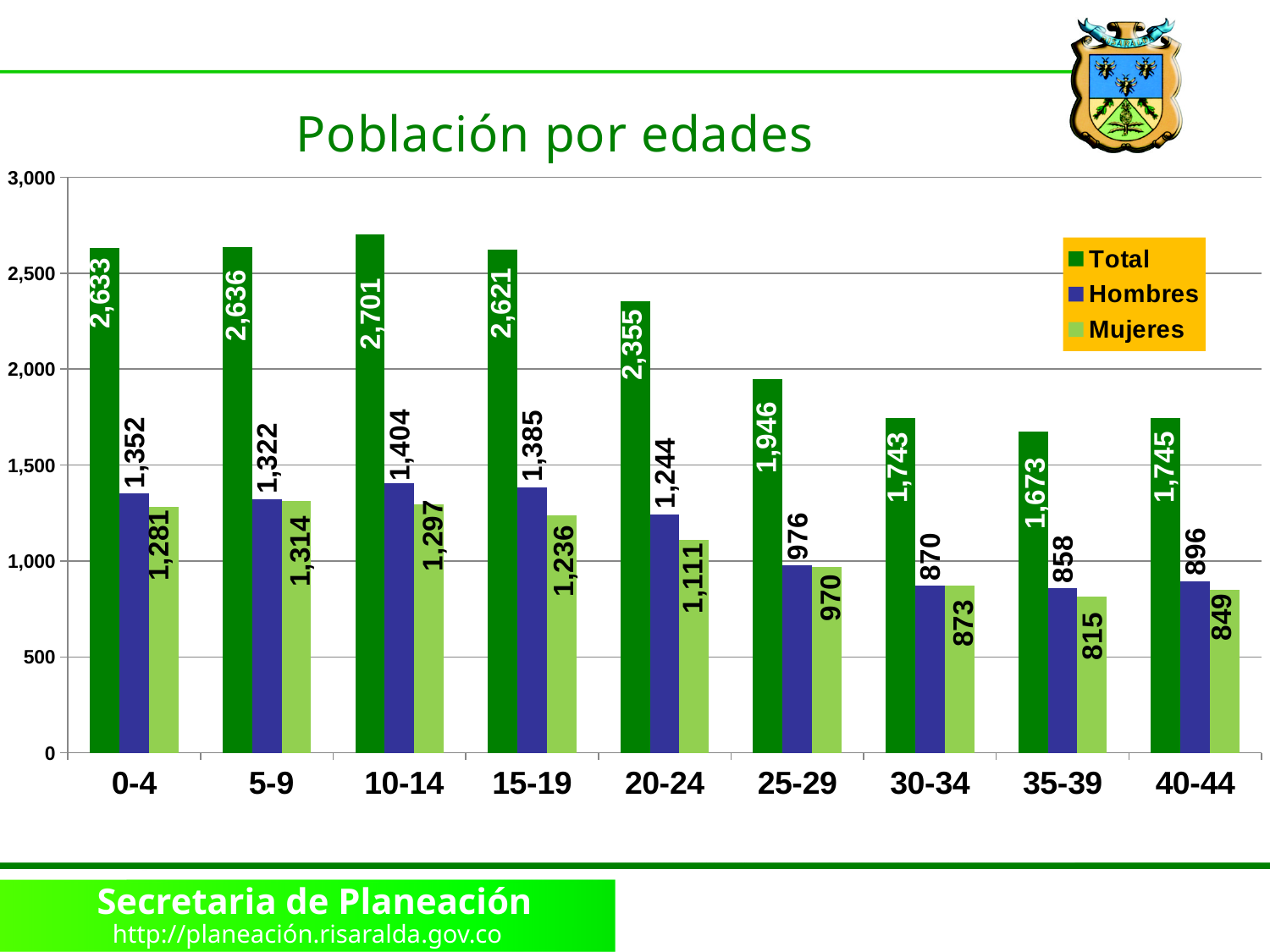
Is the Total value for the 25-29 age group greater or less than 2,000? less What is the Mujeres value for the 35-39 age group? 815 What is the Hombres value for the 20-24 age group? 1,244 How many series does the legend list? 3 How many age groups are shown on the x axis? 9 What is the title of the chart? Población por edades What kind of chart is shown on the slide? bar chart What is the Total value for the 10-14 age group? 2,701 What is the difference between the Hombres and Mujeres values for the 0-4 age group? 71 Which age group has the highest Total value? 10-14 Which is larger for the 5-9 age group, Hombres or Mujeres? Hombres Which age group has the lowest Mujeres value? 35-39